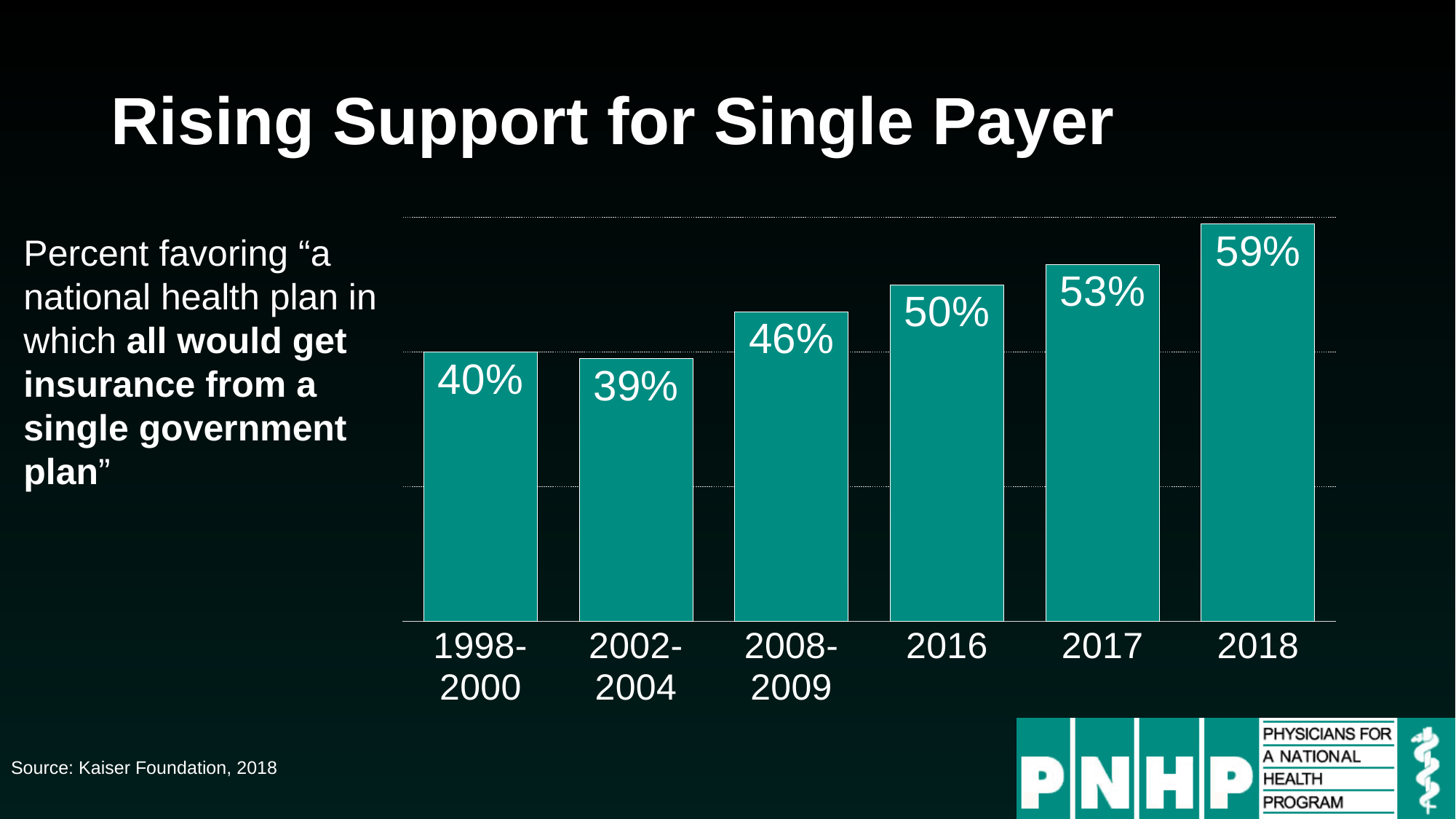
What is the difference between the 2017 value and the 2016 value? 3% What percent favored single payer in 2018? 59% What is the difference between the 2018 value and the 1998-2000 value? 19% Do the values generally rise or fall from 2002-2004 to 2018? Rise What is the value shown for 2002-2004? 39% Which period has the lowest value? 2002-2004 What is the value shown for 2008-2009? 46% How many periods are shown on the x axis? 6 Which period has the highest value? 2018 What kind of chart is shown on the slide? Bar chart What is the title of the slide containing the chart? Rising Support for Single Payer Which is larger, the value for 2016 or the value for 2008-2009? 2016